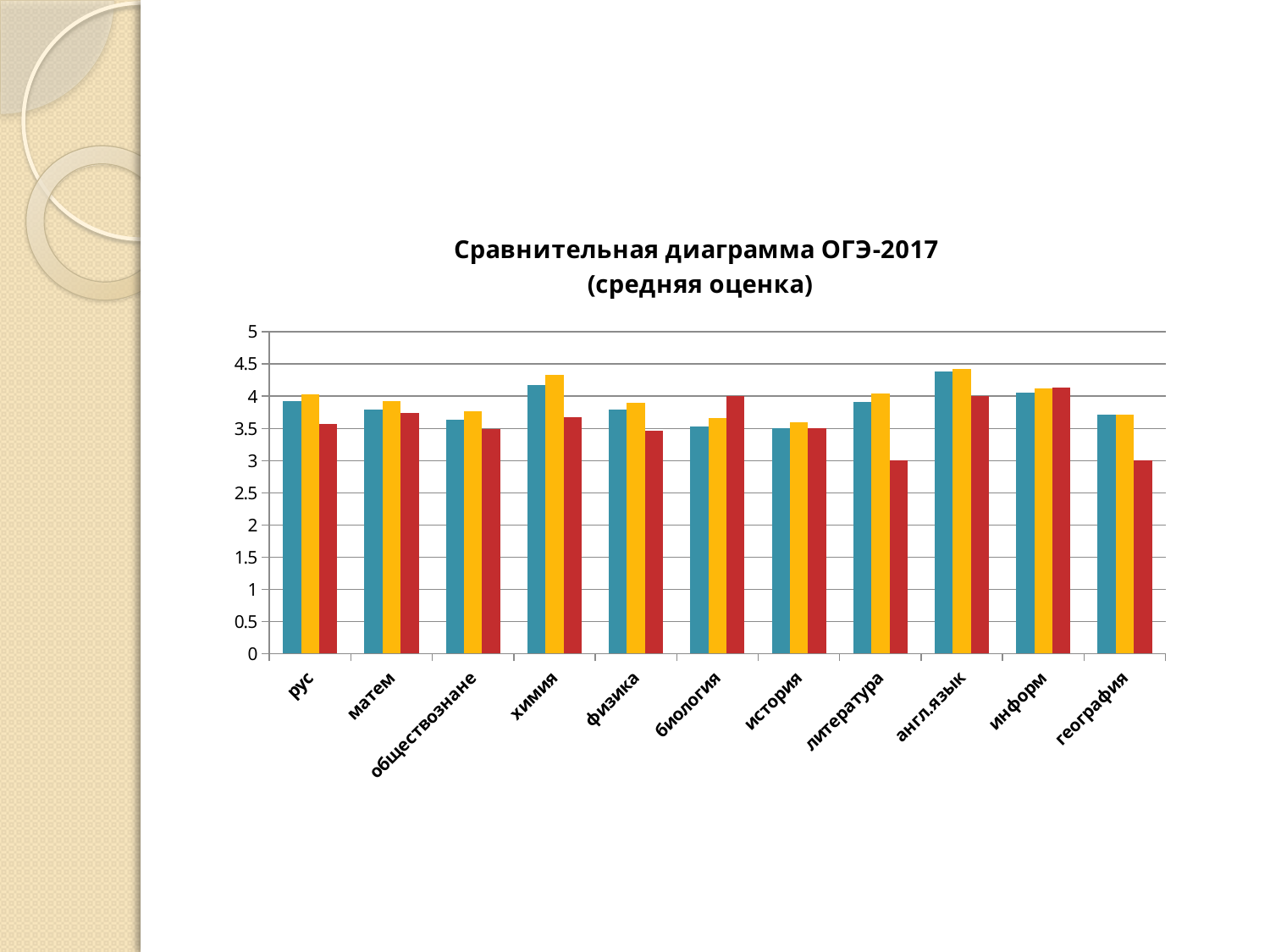
Which subject has the highest blue bar? англ.язык For биология, which is larger: the red bar or the blue bar? the red bar For литература, which is larger: the blue bar or the red bar? the blue bar What kind of chart is shown on the slide? bar chart How many subject categories are shown on the x axis? 11 Is the value of the blue bar for химия greater or less than 4? greater Is the value of the blue bar for история greater or less than 4? less What is the title of the chart? Сравнительная диаграмма ОГЭ-2017 (средняя оценка) Is the value of the red bar for география greater or less than 3.5? less How many bars are plotted for each subject category? 3